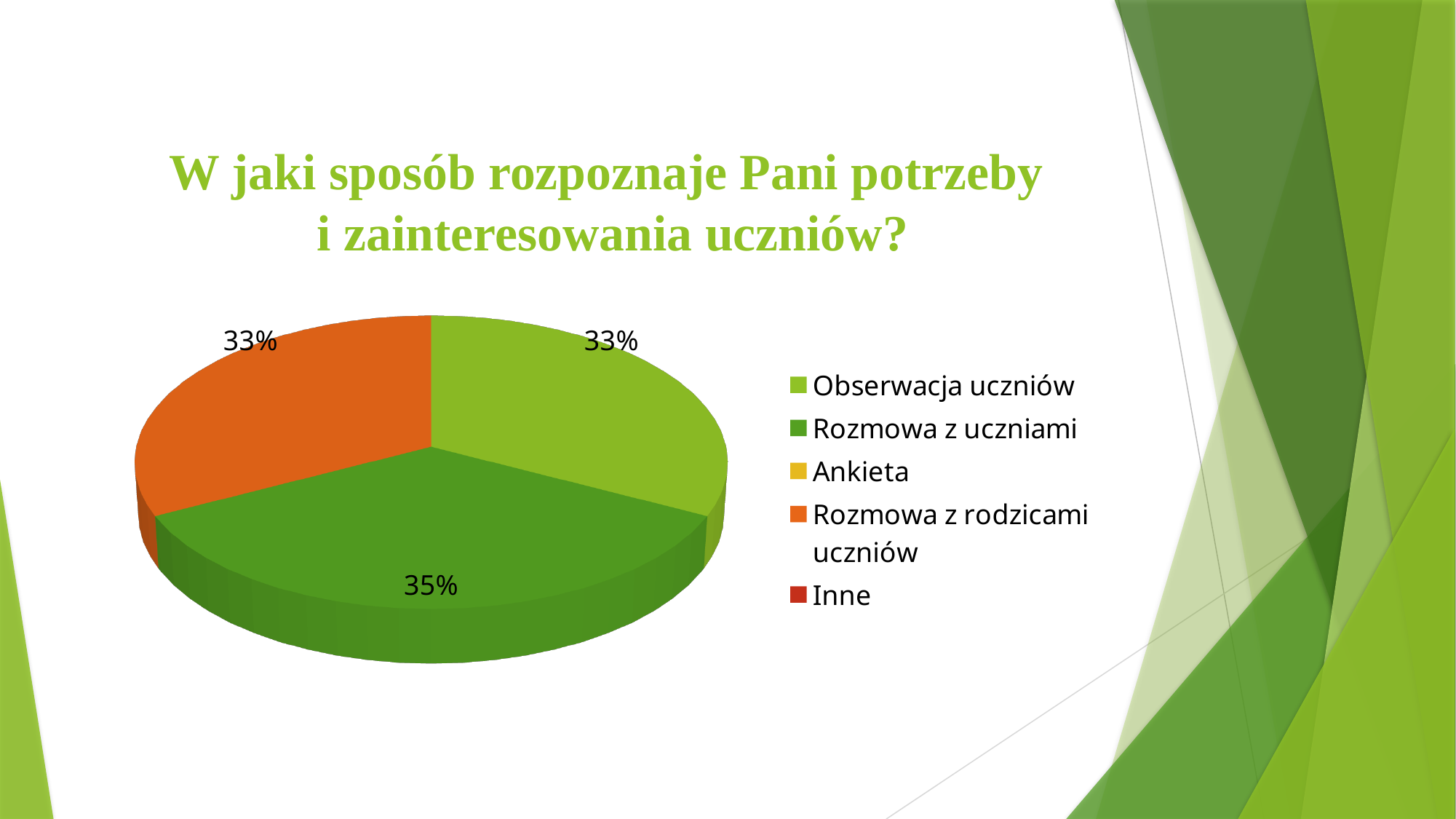
What percentage is shown for Obserwacja uczniów? 33% What is the difference in percentage points between Rozmowa z uczniami and Rozmowa z rodzicami uczniów? 2 What percentage is shown for Rozmowa z rodzicami uczniów? 33% Which category has the largest share of the pie? Rozmowa z uczniami Which is larger: the share for Rozmowa z uczniami or the share for Obserwacja uczniów? Rozmowa z uczniami What kind of chart is shown on the slide? pie chart What is the title of the slide containing the chart? W jaki sposób rozpoznaje Pani potrzeby i zainteresowania uczniów? How many categories does the legend list? 5 What percentage is shown for Rozmowa z uczniami? 35% How many slices with a percentage label are visible in the pie? 3 What colour is the slice for Rozmowa z rodzicami uczniów? orange